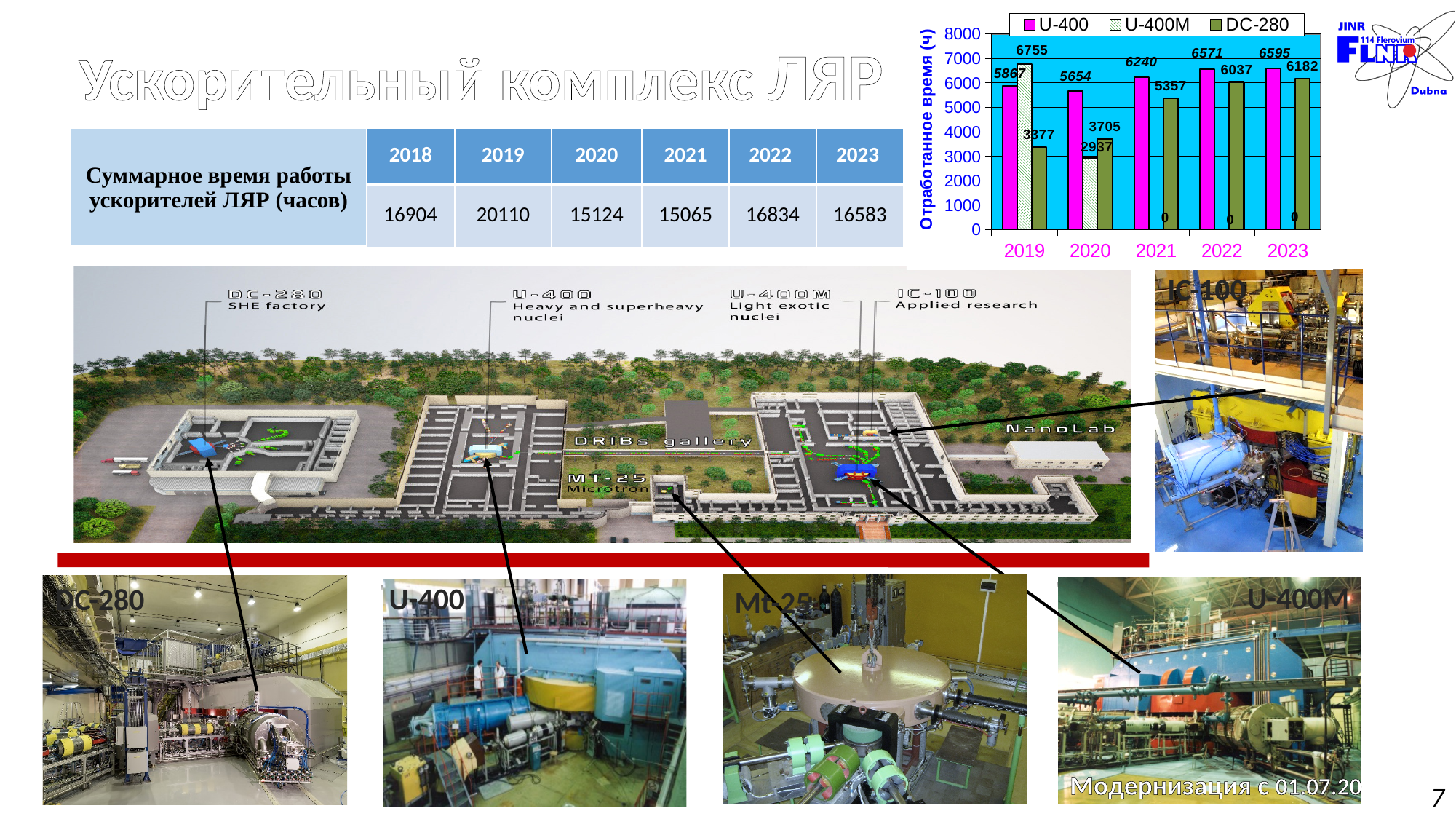
What kind of chart is shown on the slide? bar chart In which year is the U-400 value lowest? 2020 How many series does the chart legend list? 3 In which year is the DC-280 value highest? 2023 What is the value for U-400M in 2021? 0 How many years are shown on the x axis of the chart? 5 What is the value for DC-280 in 2020? 3705 Which is larger in 2019, U-400 or U-400M? U-400M What is the value for U-400 in 2019? 5867 What is the difference between the U-400 and DC-280 values in 2022? 534 What is the value for U-400M in 2019? 6755 Is the value for DC-280 in 2021 greater or less than 5000? greater